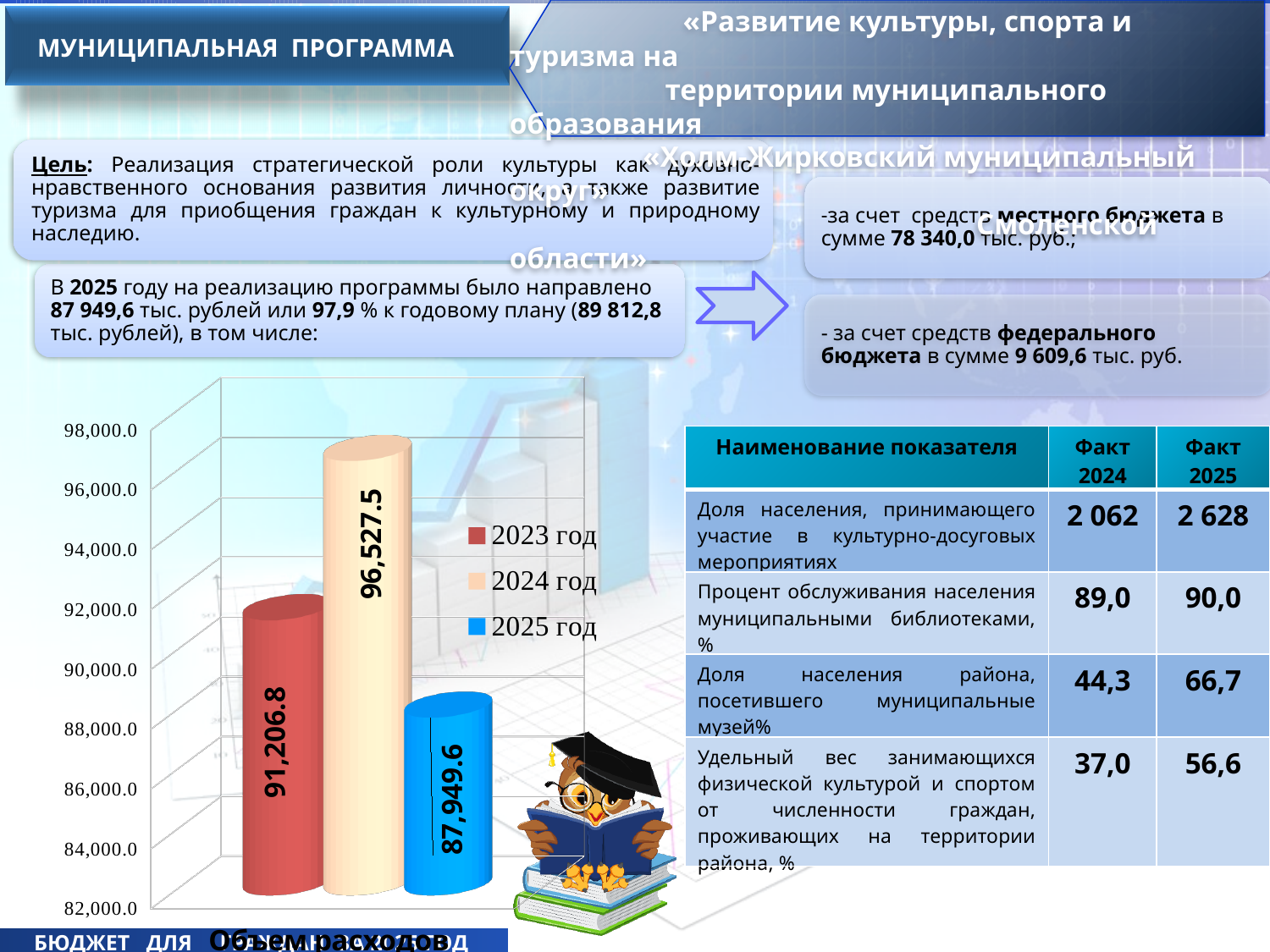
Which is larger, the value for 2023 год or the value for 2025 год? 2023 год How many bars are plotted on the chart? 3 What is the difference between the values for 2024 год and 2025 год? 8,577.9 Which year has the lowest value on the chart? 2025 год What is the difference between the values for 2024 год and 2023 год? 5,320.7 Which year has the highest value on the chart? 2024 год How many entries does the chart legend list? 3 What is the value shown for 2024 год on the chart? 96,527.5 What is the value shown for 2023 год on the chart? 91,206.8 Is the value for 2023 год greater or less than 90,000.0? greater What is the value shown for 2025 год on the chart? 87,949.6 What kind of chart is shown on the slide? bar chart